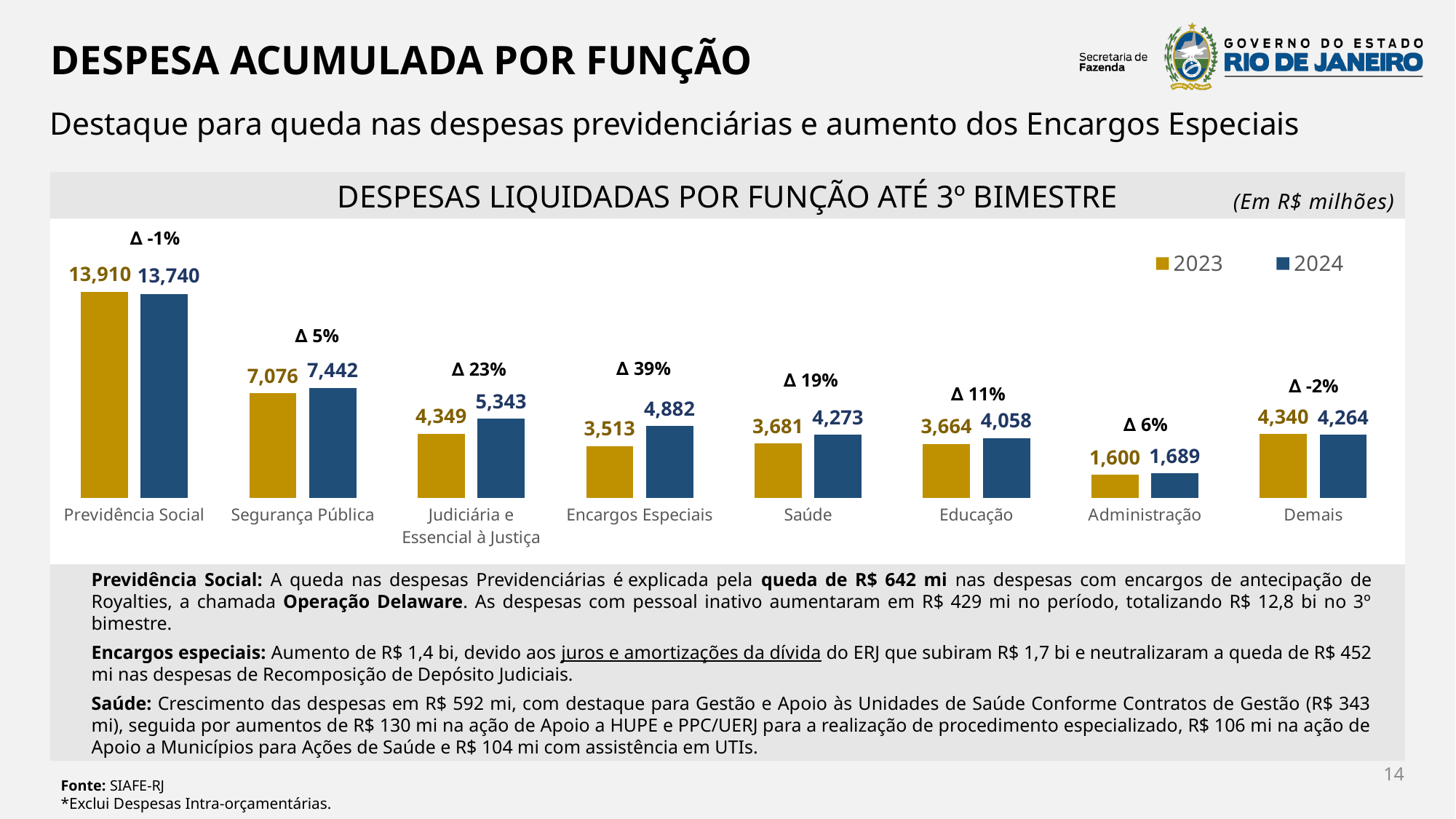
What is the 2024 value for Encargos Especiais? 4,882 What is the 2023 value for Previdência Social? 13,910 For Demais, which is larger: the 2023 value or the 2024 value? 2023 Which category has the highest 2024 value? Previdência Social What is the difference between the 2024 and 2023 values for Saúde? 592 What is the difference between the 2023 and 2024 values for Previdência Social? 170 What is the 2023 value for Administração? 1,600 How many series does the legend list? 2 What kind of chart is shown on the slide? Bar chart What is the 2024 value for Judiciária e Essencial à Justiça? 5,343 Which category has the lowest 2023 value? Administração How many categories are shown on the x axis? 8